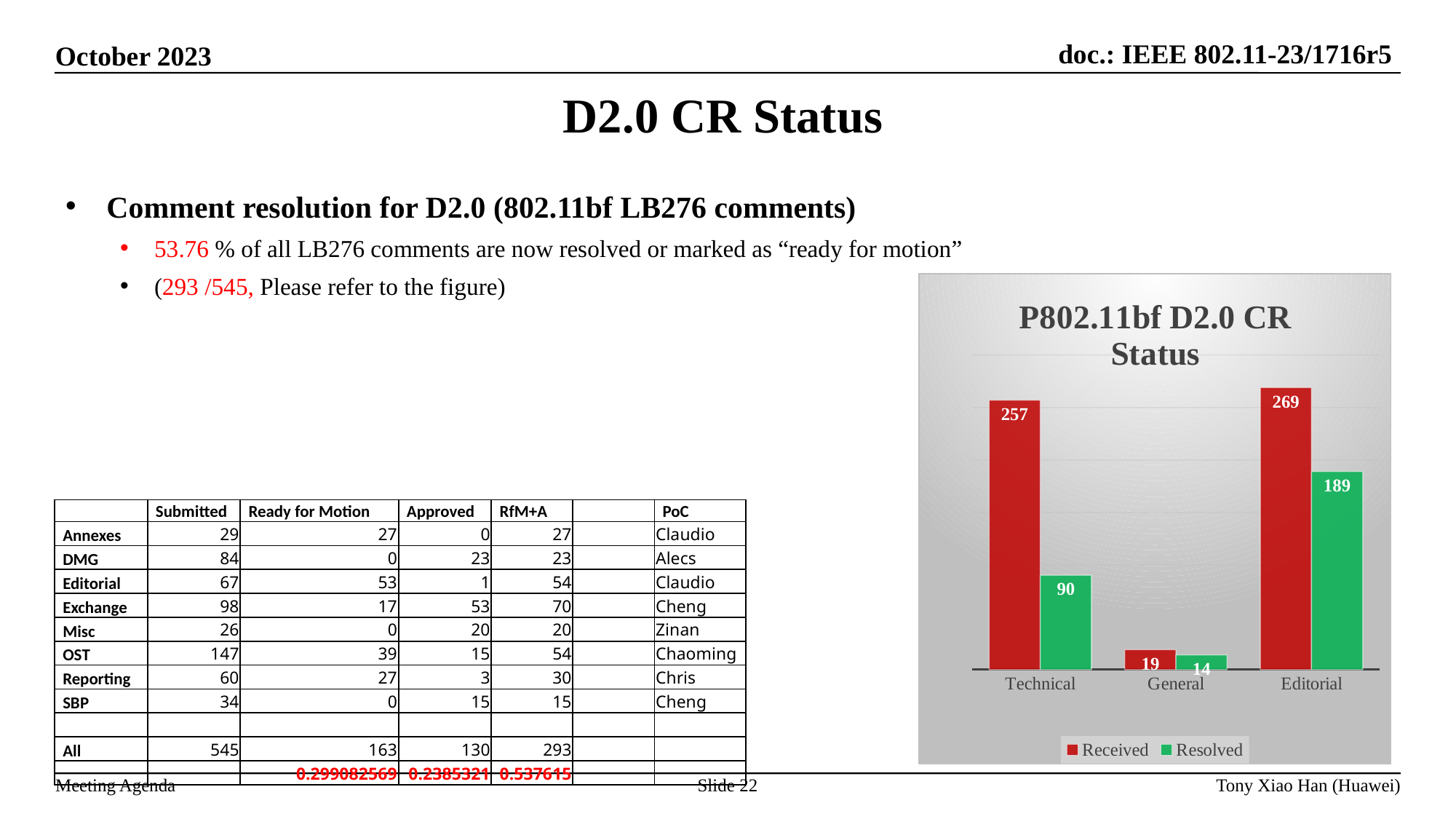
What is the Received value for Technical in the P802.11bf D2.0 CR Status chart? 257 How many categories are shown on the x axis of the P802.11bf D2.0 CR Status chart? 3 What type of chart is the P802.11bf D2.0 CR Status chart? bar chart What is the Resolved value for Editorial in the P802.11bf D2.0 CR Status chart? 189 What is the Received value for General in the P802.11bf D2.0 CR Status chart? 19 Which category has the lowest Resolved value in the P802.11bf D2.0 CR Status chart? General How many series does the legend of the P802.11bf D2.0 CR Status chart list? 2 What is the Resolved value for Technical in the P802.11bf D2.0 CR Status chart? 90 Which category has the highest Received value in the P802.11bf D2.0 CR Status chart? Editorial What is the difference between Received and Resolved for Editorial in the P802.11bf D2.0 CR Status chart? 80 Is the Resolved value for Technical larger or smaller than the Resolved value for Editorial in the P802.11bf D2.0 CR Status chart? smaller What is the difference between Received and Resolved for Technical in the P802.11bf D2.0 CR Status chart? 167